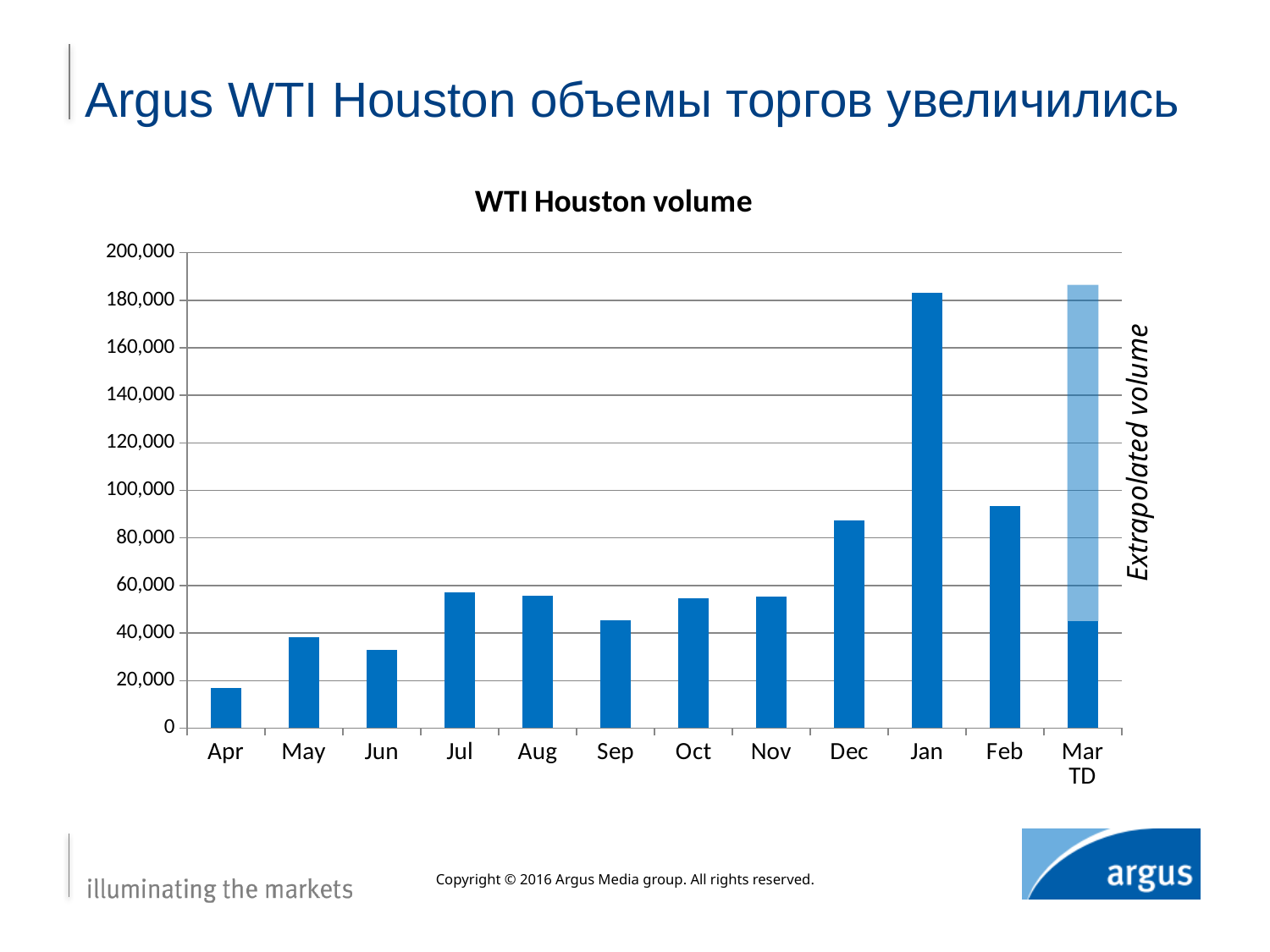
What kind of chart is shown on the slide? Bar chart Is the value for Apr greater or less than 20,000? less What is the title of the chart? WTI Houston volume Is the value for Dec greater or less than 80,000? greater Is the value for Jan greater or less than 160,000? greater Which is larger, the volume for Jul or the volume for Sep? Jul Excluding the extrapolated Mar TD bar, which month has the highest WTI Houston volume? Jan How many months are shown on the x axis of the chart? 12 Which is larger, the volume for Jan or the volume for Feb? Jan Which month has the lowest WTI Houston volume? Apr What does the light blue portion of the Mar TD bar represent, according to the label on the chart? Extrapolated volume